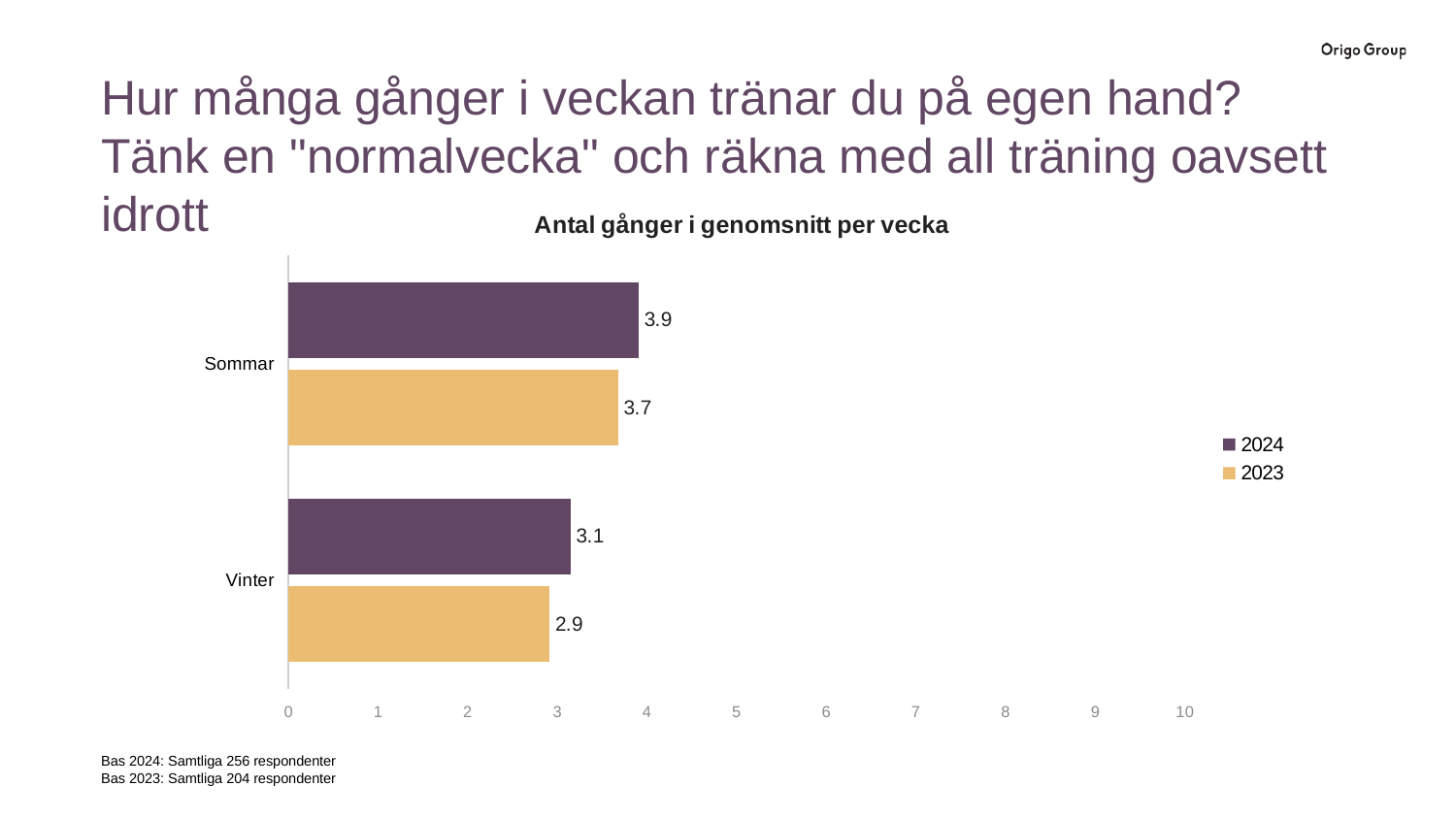
What is the value for Vinter in the 2024 series? 3.1 What is the difference between the Sommar and Vinter values in the 2024 series? 0.8 What is the value for Sommar in the 2024 series? 3.9 What kind of chart is shown on the slide? Bar chart How many series does the legend list? 2 What is the difference between the 2024 and 2023 values for Sommar? 0.2 Which category has the lowest value in the 2023 series? Vinter What is the value for Sommar in the 2023 series? 3.7 Which category has the highest value in the 2024 series? Sommar What is the value for Vinter in the 2023 series? 2.9 How many categories are shown on the chart? 2 Which is larger: the 2024 value for Vinter or the 2023 value for Vinter? 2024